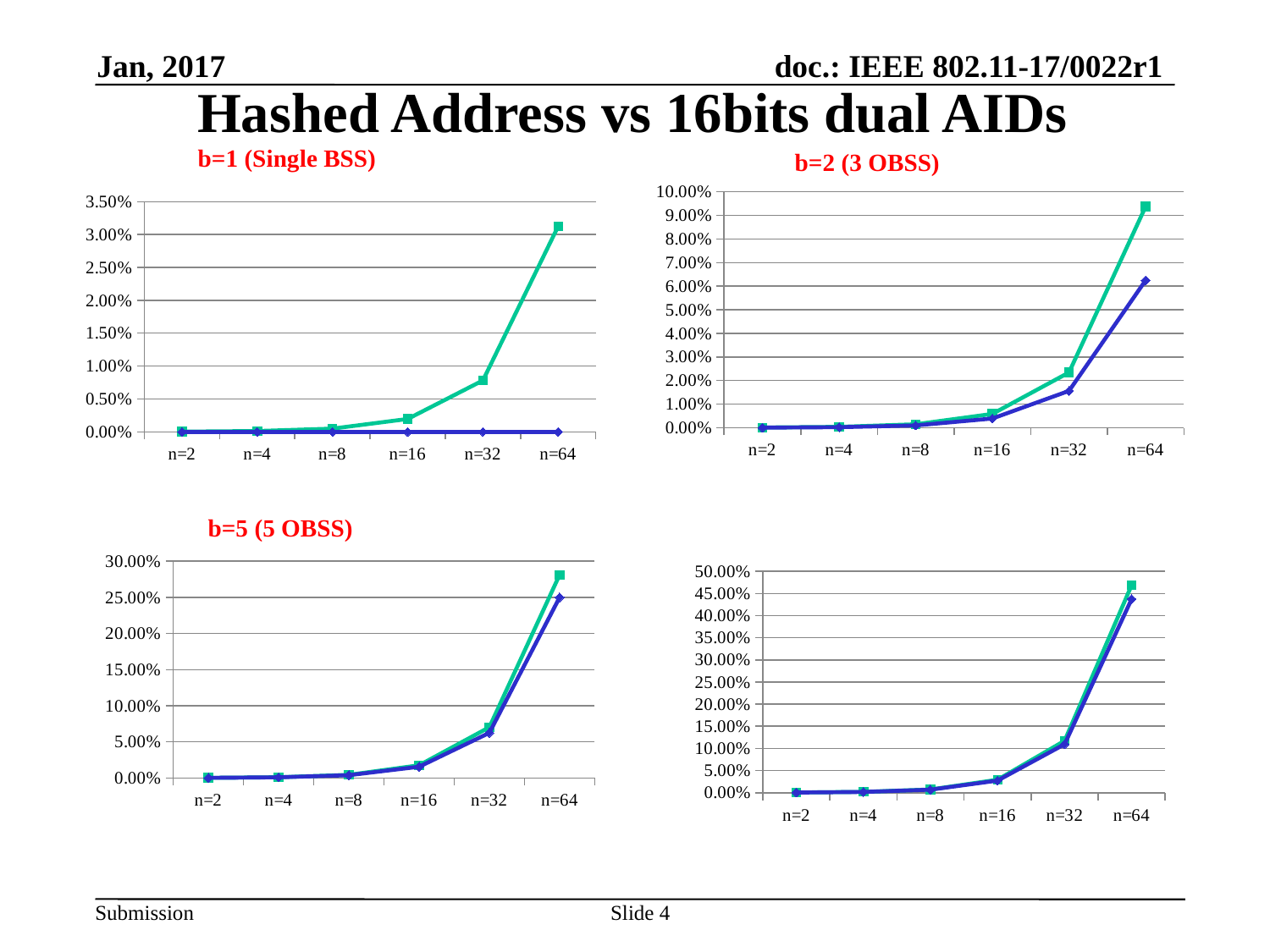
How many x-axis categories does the 'b=2 (3 OBSS)' chart show? 6 How many x-axis categories does the bottom-right chart show? 6 In the 'b=2 (3 OBSS)' chart, is the value of the green line at n=64 greater or less than 8.00%? greater In the 'b=5 (5 OBSS)' chart, is the value of the green line at n=32 greater or less than 10.00%? less What kind of chart is the 'b=1 (Single BSS)' chart? line chart In the 'b=1 (Single BSS)' chart, is the value of the green line at n=64 greater or less than 2.50%? greater In the 'b=2 (3 OBSS)' chart, which line is higher at n=64, the green line or the blue line? green What is the title of the top-right chart? b=2 (3 OBSS) In the 'b=5 (5 OBSS)' chart, at which x-axis category does the green line reach its highest value? n=64 In the 'b=5 (5 OBSS)' chart, do the values rise or fall as n increases from n=2 to n=64? rise